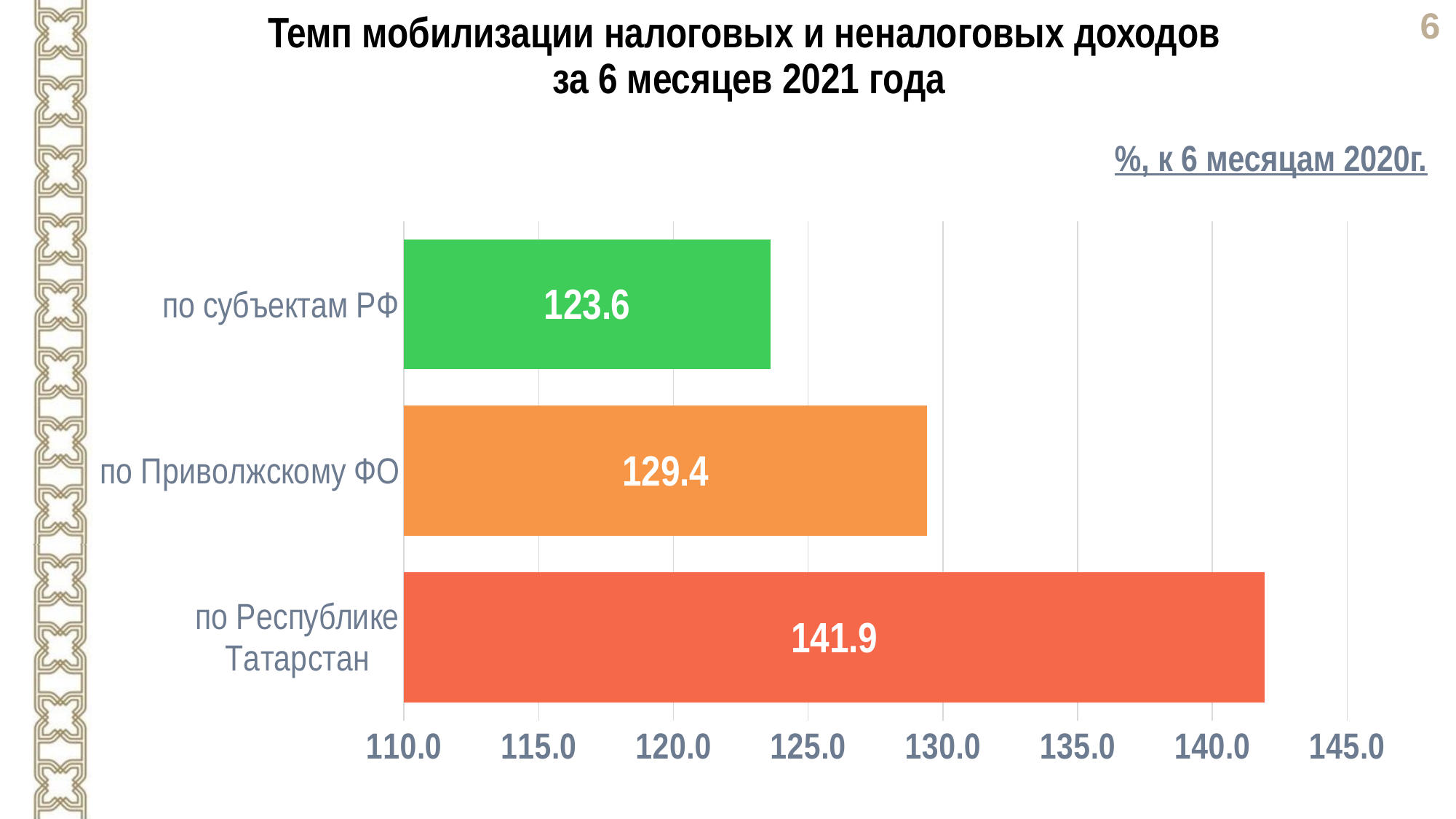
What colour is the bar for по Республике Татарстан? red Which category has the highest value? по Республике Татарстан What is the difference between the values for по Республике Татарстан and по субъектам РФ? 18.3 Which category has the lowest value? по субъектам РФ Which is larger, the value for по Приволжскому ФО or the value for по субъектам РФ? по Приволжскому ФО What is the difference between the values for по Приволжскому ФО and по субъектам РФ? 5.8 What is the value for по Приволжскому ФО? 129.4 How many categories are shown in the chart? 3 What kind of chart is shown on the slide? bar chart What is the value for по субъектам РФ? 123.6 Is the value for по Республике Татарстан greater or less than 140.0? greater What is the value for по Республике Татарстан? 141.9